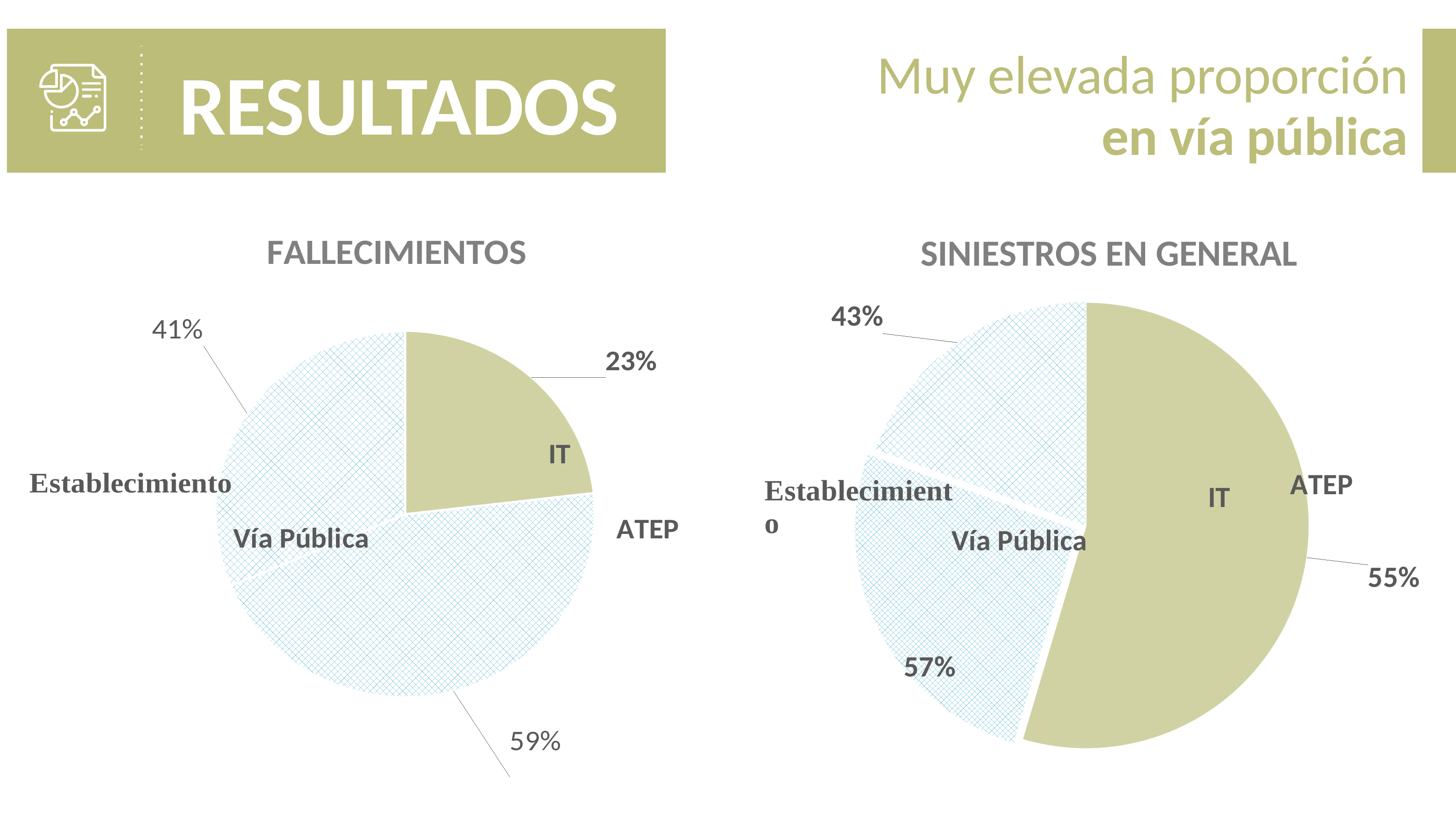
In the FALLECIMIENTOS chart, what percentage is shown for IT? 23% In the SINIESTROS EN GENERAL chart, what percentage is shown for IT? 55% In the SINIESTROS EN GENERAL chart, what percentage label is shown for Establecimiento? 43% What type of charts are shown on the slide? Pie charts What is the difference between the IT percentage in the SINIESTROS EN GENERAL chart and the IT percentage in the FALLECIMIENTOS chart? 32% In the SINIESTROS EN GENERAL chart, what percentage label is shown for Vía Pública? 57% In the FALLECIMIENTOS chart, what percentage label is shown for Establecimiento? 41% Which chart shows a larger percentage for IT, FALLECIMIENTOS or SINIESTROS EN GENERAL? SINIESTROS EN GENERAL In the FALLECIMIENTOS chart, what is the difference between the Vía Pública and Establecimiento percentage labels? 18% In the FALLECIMIENTOS chart, what percentage label is shown for Vía Pública? 59% What is the title of the pie chart on the left side of the slide? FALLECIMIENTOS In the SINIESTROS EN GENERAL chart, which is larger, the Vía Pública label or the Establecimiento label? Vía Pública